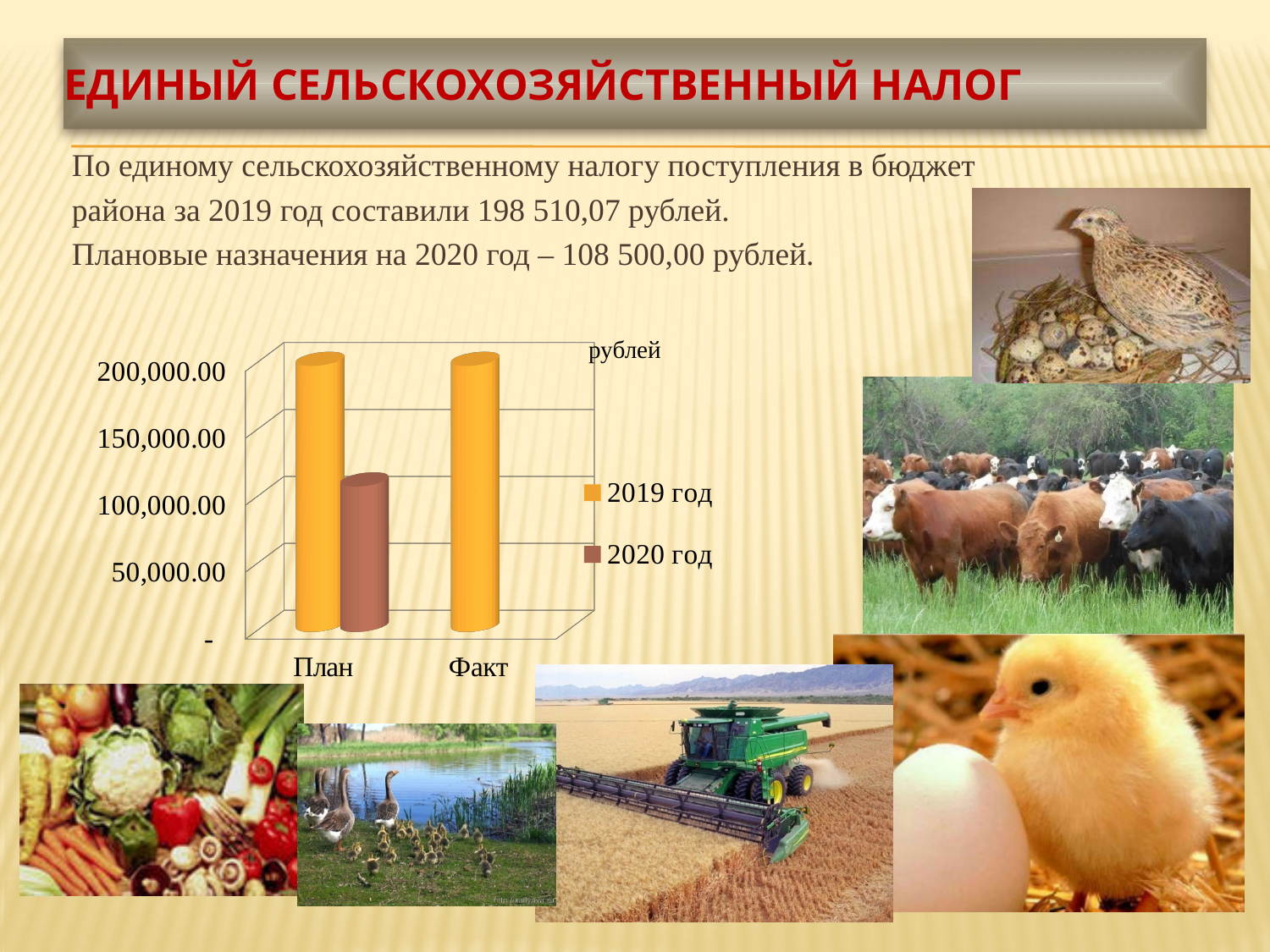
Which series has the lowest bar in the chart? 2020 год What kind of chart is shown on the slide? bar chart How many series does the chart legend list? 2 Is the value for 2020 год in the План category greater or less than 150,000.00? less Is the value for 2019 год in the План category greater or less than 150,000.00? greater Is the value for 2019 год in the Факт category greater or less than 100,000.00? greater What are the entries in the chart legend? 2019 год, 2020 год What are the two categories on the x axis of the chart? План, Факт How many categories are shown on the x axis of the chart? 2 In the План category, which series has the larger value, 2019 год or 2020 год? 2019 год